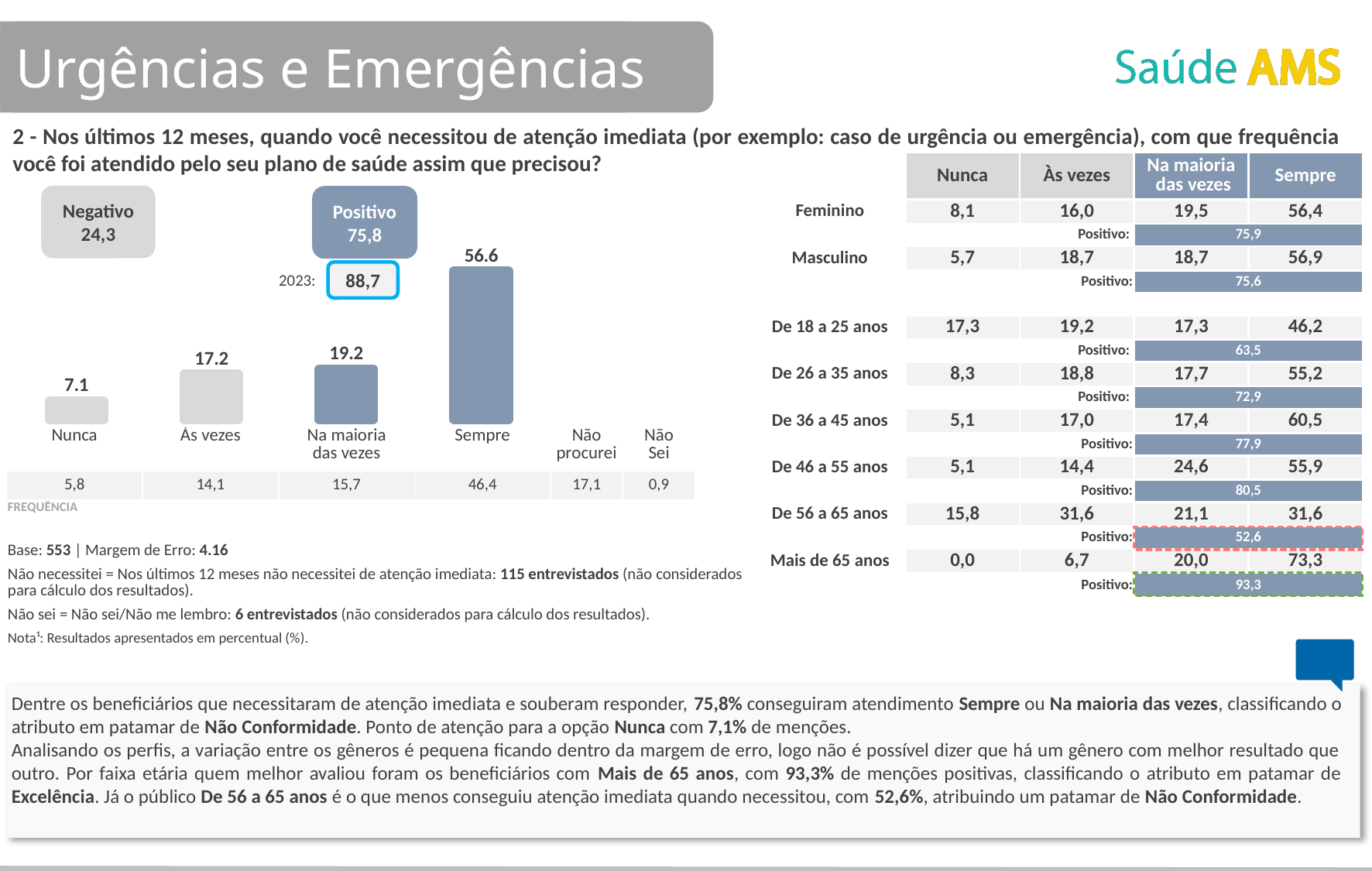
What is the difference between the values for "Às vezes" and "Nunca"? 10.1 What is the value of the bar for "Nunca"? 7.1 What type of chart is shown on the slide? bar chart What colour are the bars for "Nunca" and "Às vezes"? grey Which category has the highest bar? Sempre What is the value of the bar for "Às vezes"? 17.2 Which is larger, the value for "Às vezes" or the value for "Sempre"? Sempre What is the value of the bar for "Na maioria das vezes"? 19.2 What is the difference between the values for "Sempre" and "Na maioria das vezes"? 37.4 How many bars are plotted in the chart? 4 Which category has the lowest bar? Nunca What is the value of the bar for "Sempre"? 56.6